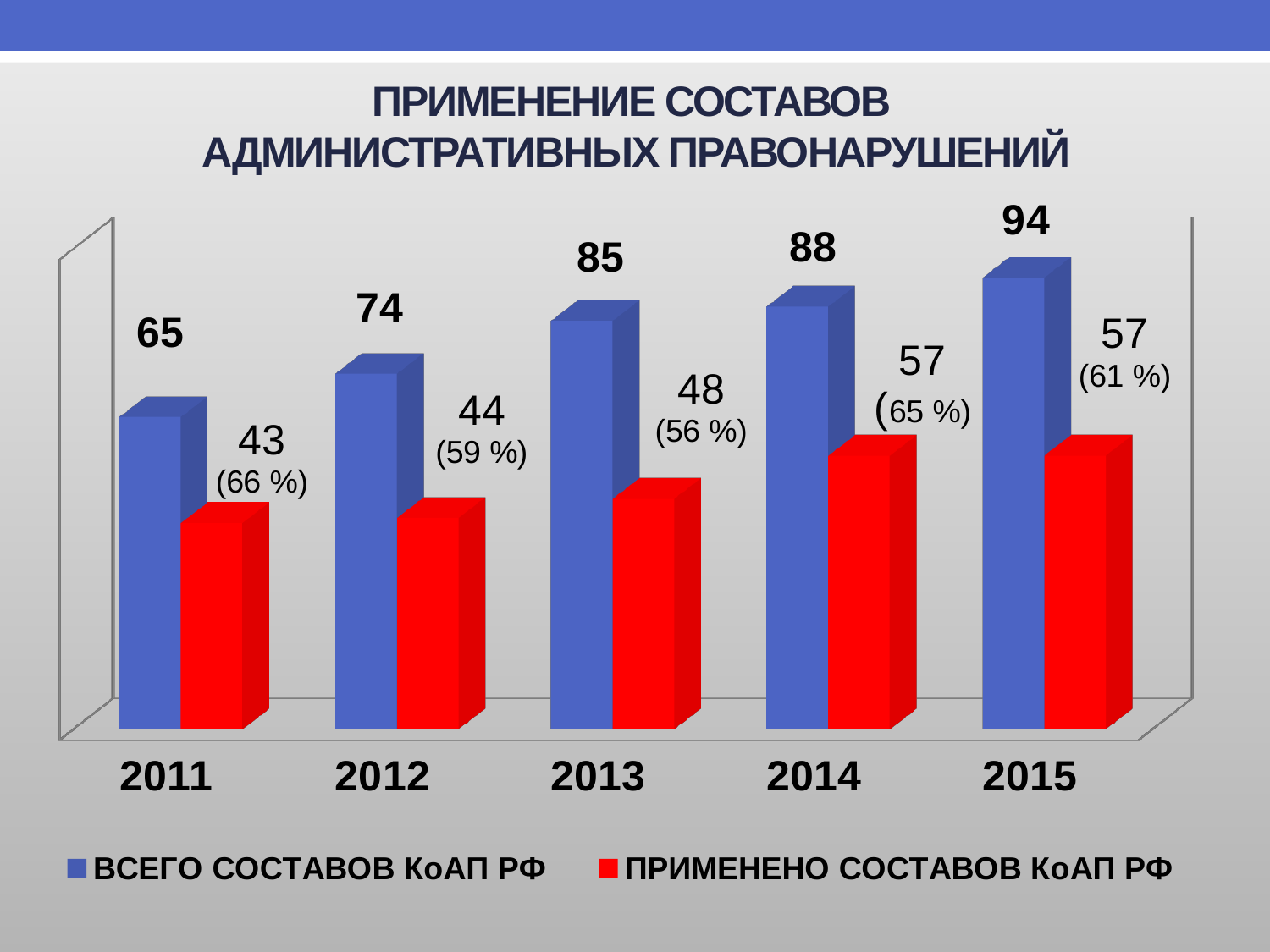
Which is larger: ПРИМЕНЕНО СОСТАВОВ КоАП РФ in 2013 or in 2014? 2014 What is the value of ВСЕГО СОСТАВОВ КоАП РФ for 2013? 85 Which year has the lowest value for ПРИМЕНЕНО СОСТАВОВ КоАП РФ? 2011 What is the difference between ВСЕГО СОСТАВОВ КоАП РФ and ПРИМЕНЕНО СОСТАВОВ КоАП РФ in 2015? 37 How many years are shown on the x axis? 5 By how much did ВСЕГО СОСТАВОВ КоАП РФ increase from 2011 to 2015? 29 How many series does the legend list? 2 What percentage is shown next to the ПРИМЕНЕНО СОСТАВОВ КоАП РФ value for 2011? 66 % Which year has the highest value for ВСЕГО СОСТАВОВ КоАП РФ? 2015 What is the value of ПРИМЕНЕНО СОСТАВОВ КоАП РФ for 2012? 44 What kind of chart is shown on the slide? Bar chart Does the value of ВСЕГО СОСТАВОВ КоАП РФ rise or fall from 2011 to 2015? Rise